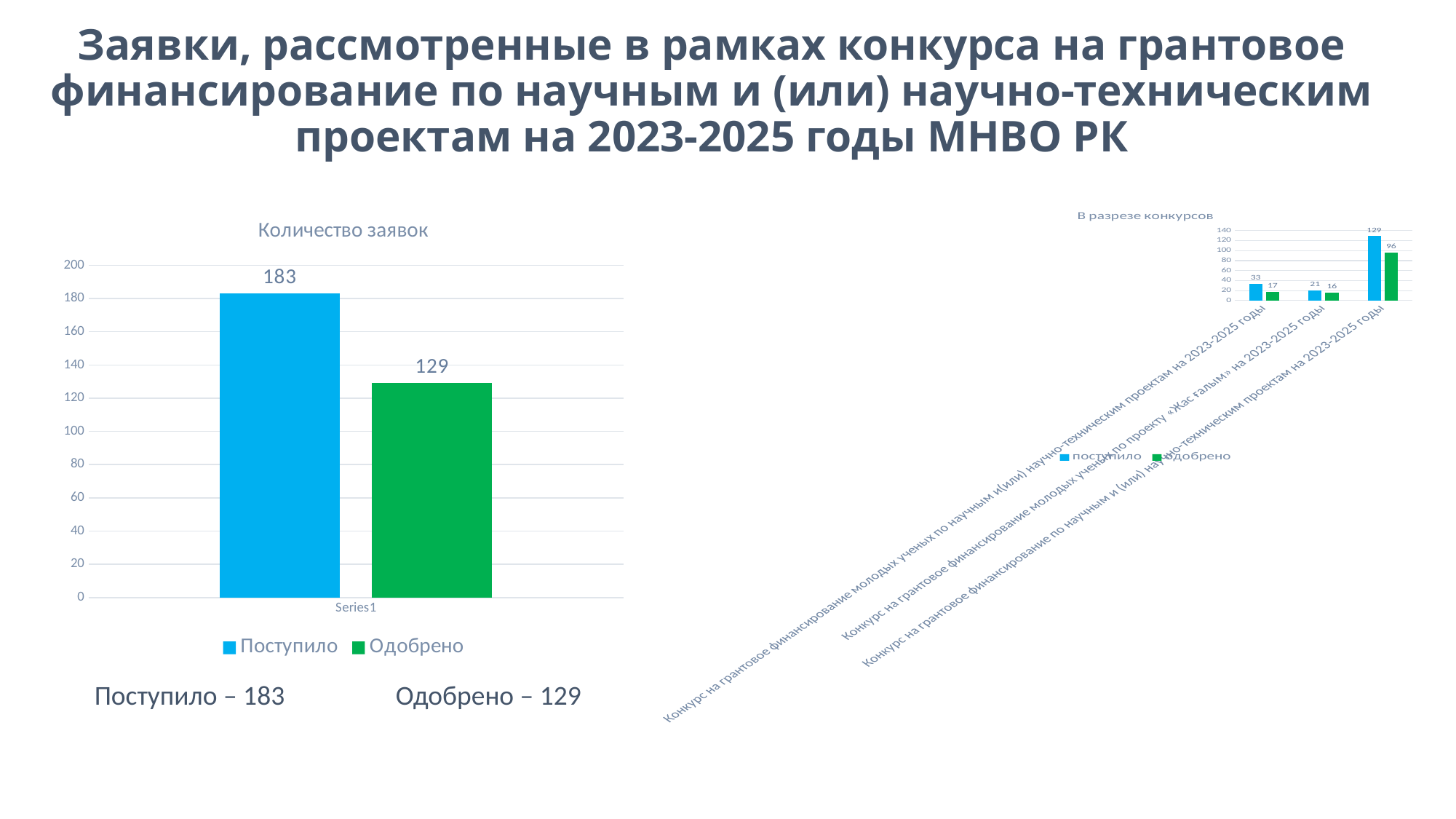
In the chart titled "В разрезе конкурсов", how many categories are shown on the x axis? 3 In the chart titled "В разрезе конкурсов", what is the одобрено value for the third (rightmost) category? 96 In the chart titled "В разрезе конкурсов", which category has the highest поступило value? The third (rightmost) category In the chart titled "Количество заявок", what is the difference between Поступило and Одобрено? 54 In the chart titled "Количество заявок", what is the value for Одобрено? 129 In the chart titled "В разрезе конкурсов", what is the поступило value for the first (leftmost) category? 33 What kind of chart is the chart titled "Количество заявок"? Bar chart In the chart titled "В разрезе конкурсов", what is the difference between поступило and одобрено for the second category (the «Жас ғалым» competition)? 5 In the chart titled "Количество заявок", what is the value for Поступило? 183 In the chart titled "Количество заявок", which is larger, Поступило or Одобрено? Поступило How many series does the legend of the chart titled "Количество заявок" list? 2 In the chart titled "Количество заявок", what colour is the Одобрено bar? Green